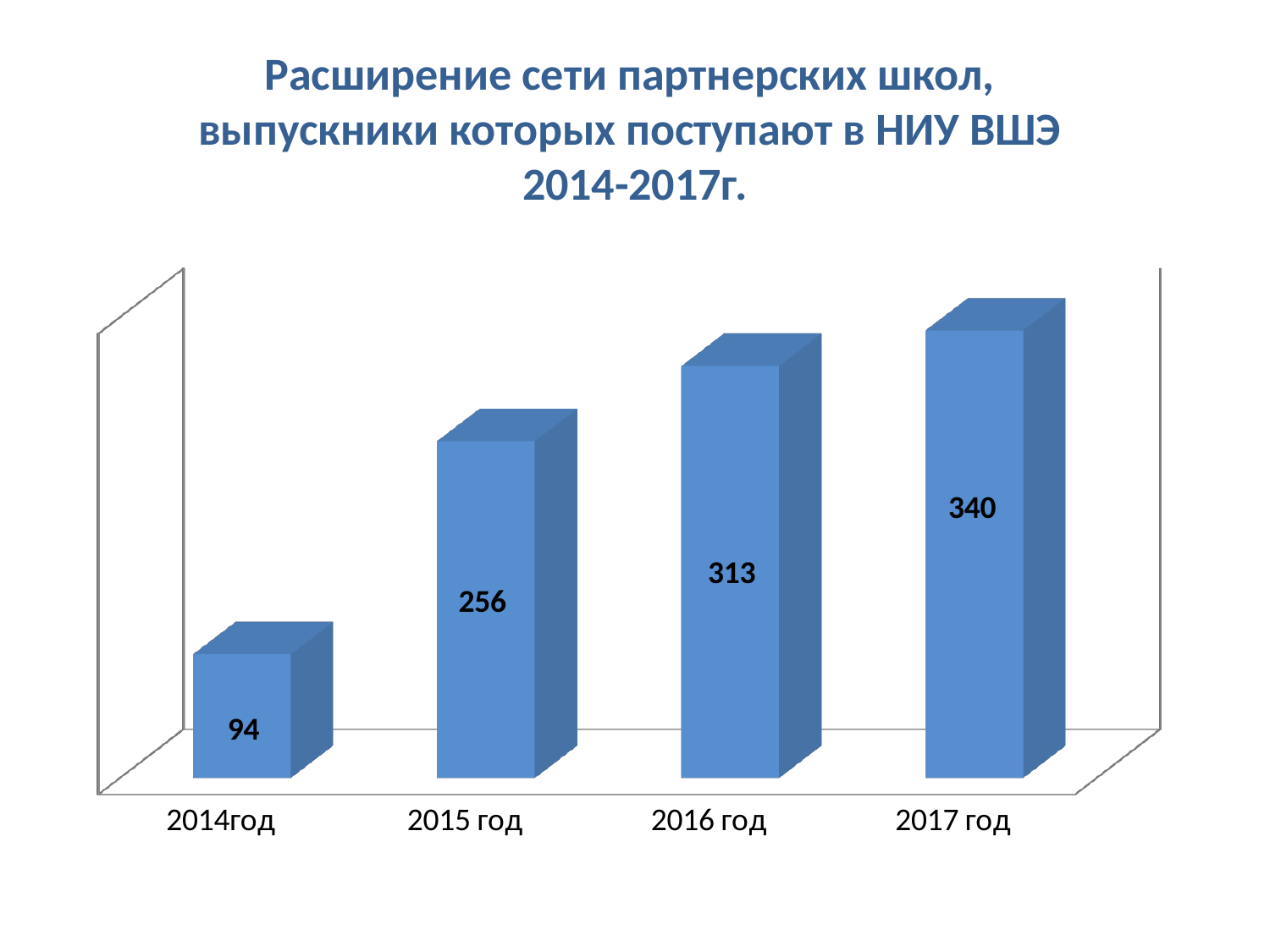
How many years are shown on the chart? 4 Which is larger, the value for 2015 год or the value for 2016 год? 2016 год What is the difference between the values for 2016 год and 2015 год? 57 What is the value for 2014 год? 94 Do the values rise or fall from 2014 год to 2017 год? rise What is the value for 2017 год? 340 What is the difference between the values for 2017 год and 2014 год? 246 Which year has the highest value? 2017 год What kind of chart is shown on the slide? bar chart What is the value for 2016 год? 313 What is the value for 2015 год? 256 Which year has the lowest value? 2014 год